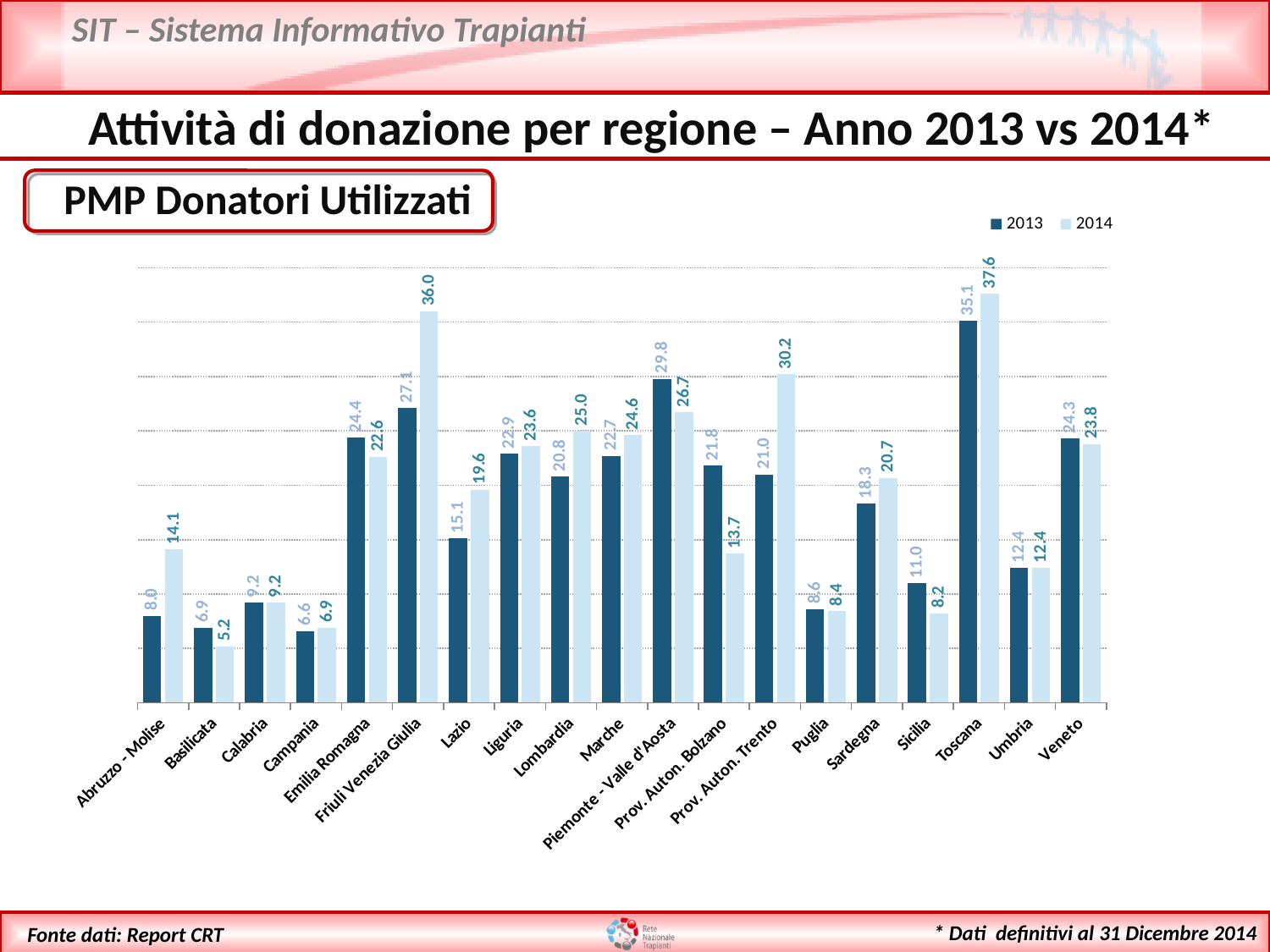
Which region has the lowest 2014 value? Basilicata What is the 2014 value for Prov. Auton. Bolzano? 13.7 What is the difference between the 2014 and 2013 values for Prov. Auton. Trento? 9.2 Which region has the highest 2014 value? Toscana What is the 2014 value for Friuli Venezia Giulia? 36.0 What is the difference between the 2013 and 2014 values for Toscana? 2.5 Which region has the lowest 2013 value? Campania What kind of chart is shown on the slide? Bar chart How many regions are shown on the x axis? 19 What is the 2013 value for Piemonte - Valle d'Aosta? 29.8 Which is larger for Lazio, the 2013 value or the 2014 value? 2014 How many series does the legend list? 2